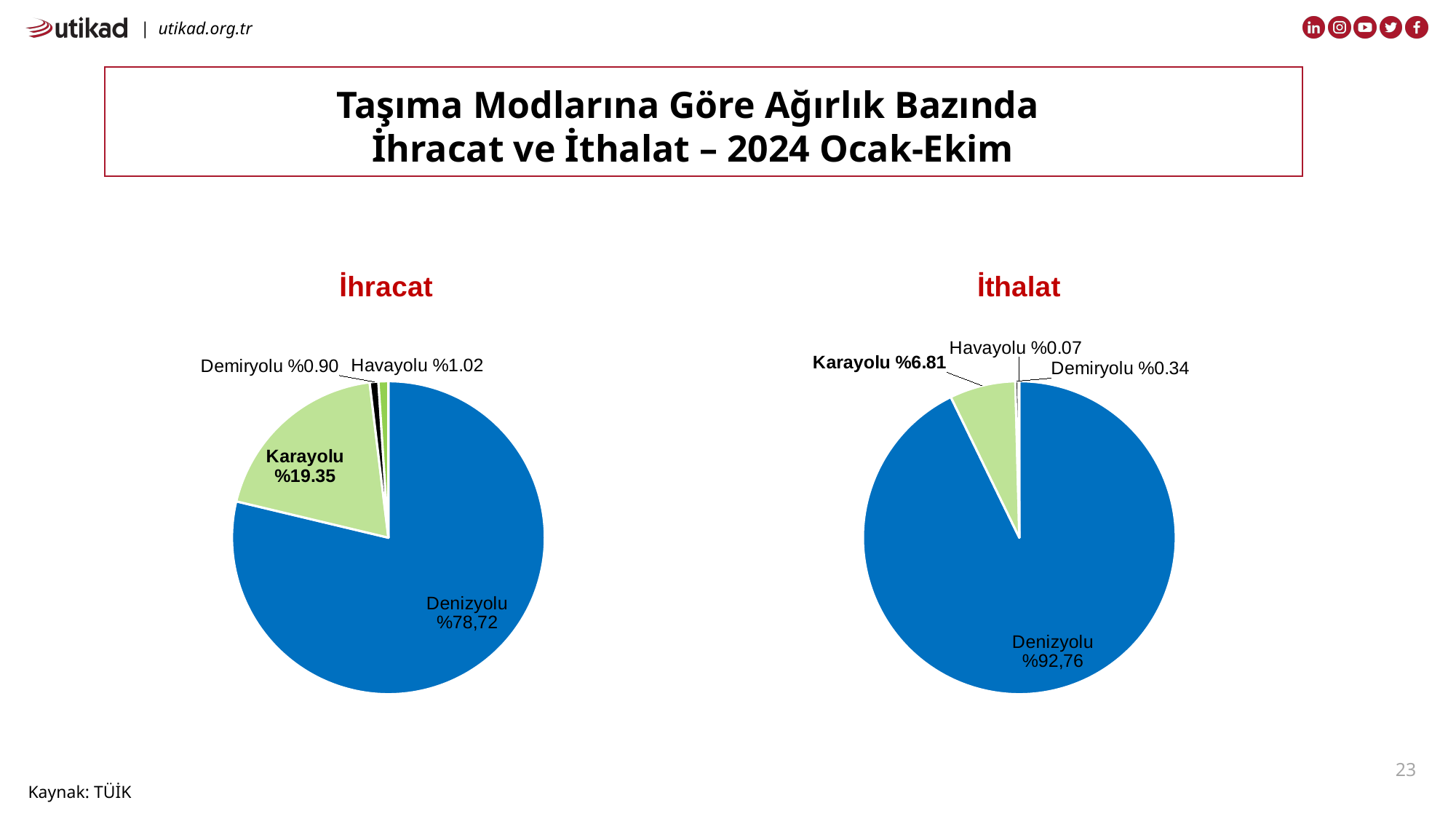
What type of chart is used for İhracat and İthalat on this slide? Pie chart Which is larger in the İhracat chart: Havayolu or Demiryolu? Havayolu In the İthalat chart, what is the difference between the Karayolu and Demiryolu shares? 6.47 percentage points In the İhracat chart, which transport mode has the smallest share? Demiryolu In the İhracat chart, what share does Denizyolu have? %78,72 In the İhracat chart, what is the value for Karayolu? %19.35 In the İhracat chart, which transport mode has the largest share? Denizyolu What is the source cited at the bottom of the slide? TÜİK In the İthalat chart, what is the value for Denizyolu? %92,76 In the İthalat chart, which transport mode has the smallest share? Havayolu How many slices does the İthalat pie chart have? 4 In the İthalat chart, what is the value for Havayolu? %0.07